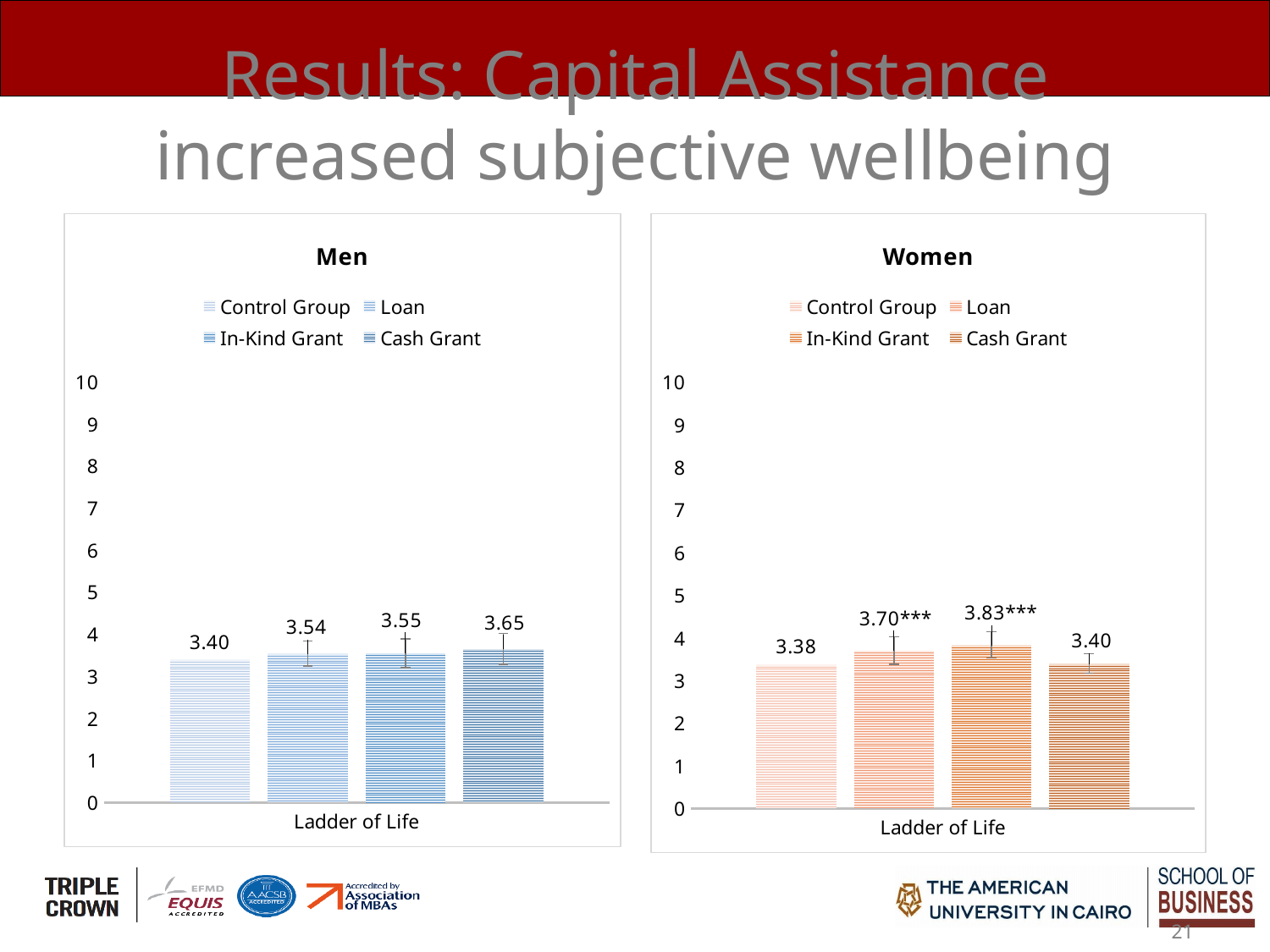
In the Women chart, which group has the highest value? In-Kind Grant How many series does the legend of the Men chart list? 4 In the Women chart, what is the difference between the In-Kind Grant value and the Control Group value? 0.45 In the Men chart, what is the difference between the Cash Grant value and the Control Group value? 0.25 In the Men chart, what is the value for the Control Group? 3.40 In the Women chart, what is the value labelled for the In-Kind Grant group? 3.83*** In the Women chart, what is the value for the Control Group? 3.38 In the Men chart, what is the value for the Cash Grant group? 3.65 In the Men chart, which group has the highest value? Cash Grant In the Women chart, which is larger, the Loan value or the Cash Grant value? Loan What kind of chart is the Women chart? Bar chart In the Men chart, which group has the lowest value? Control Group